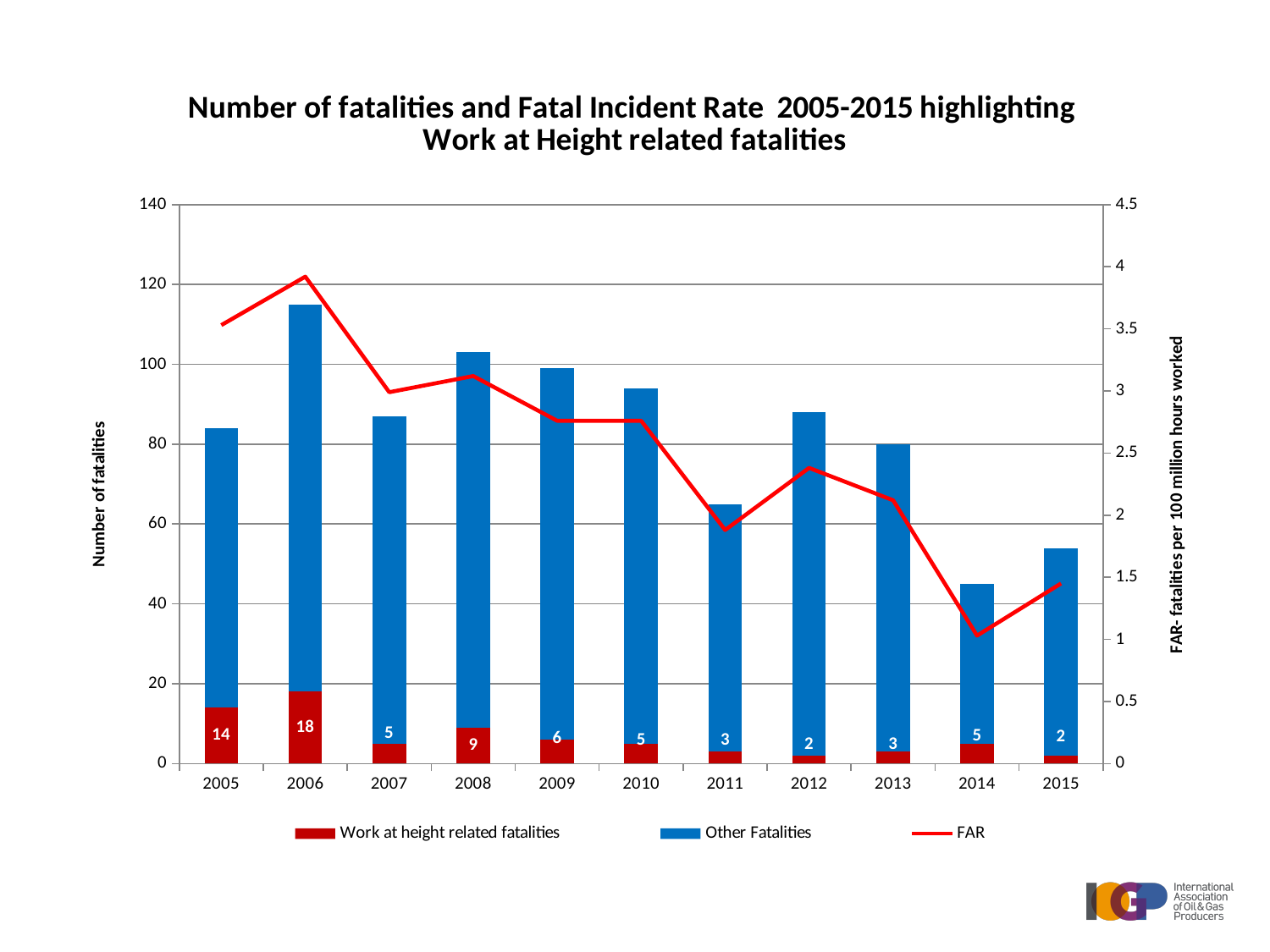
What is the difference between the work at height related fatalities in 2006 and 2005? 4 Does the FAR line generally rise or fall from 2005 to 2015? fall Is the total number of fatalities for 2006 greater or less than 100? greater Which year had more work at height related fatalities, 2008 or 2009? 2008 How many work at height related fatalities are labelled for 2015? 2 How many work at height related fatalities were there in 2006? 18 How many series does the legend list? 3 Is the total number of fatalities for 2014 greater or less than 60? less How many years are shown on the x axis? 11 Which year has the highest number of work at height related fatalities? 2006 What is the number of work at height related fatalities shown for 2008? 9 What is the label of the right-hand vertical axis? FAR- fatalities per 100 million hours worked